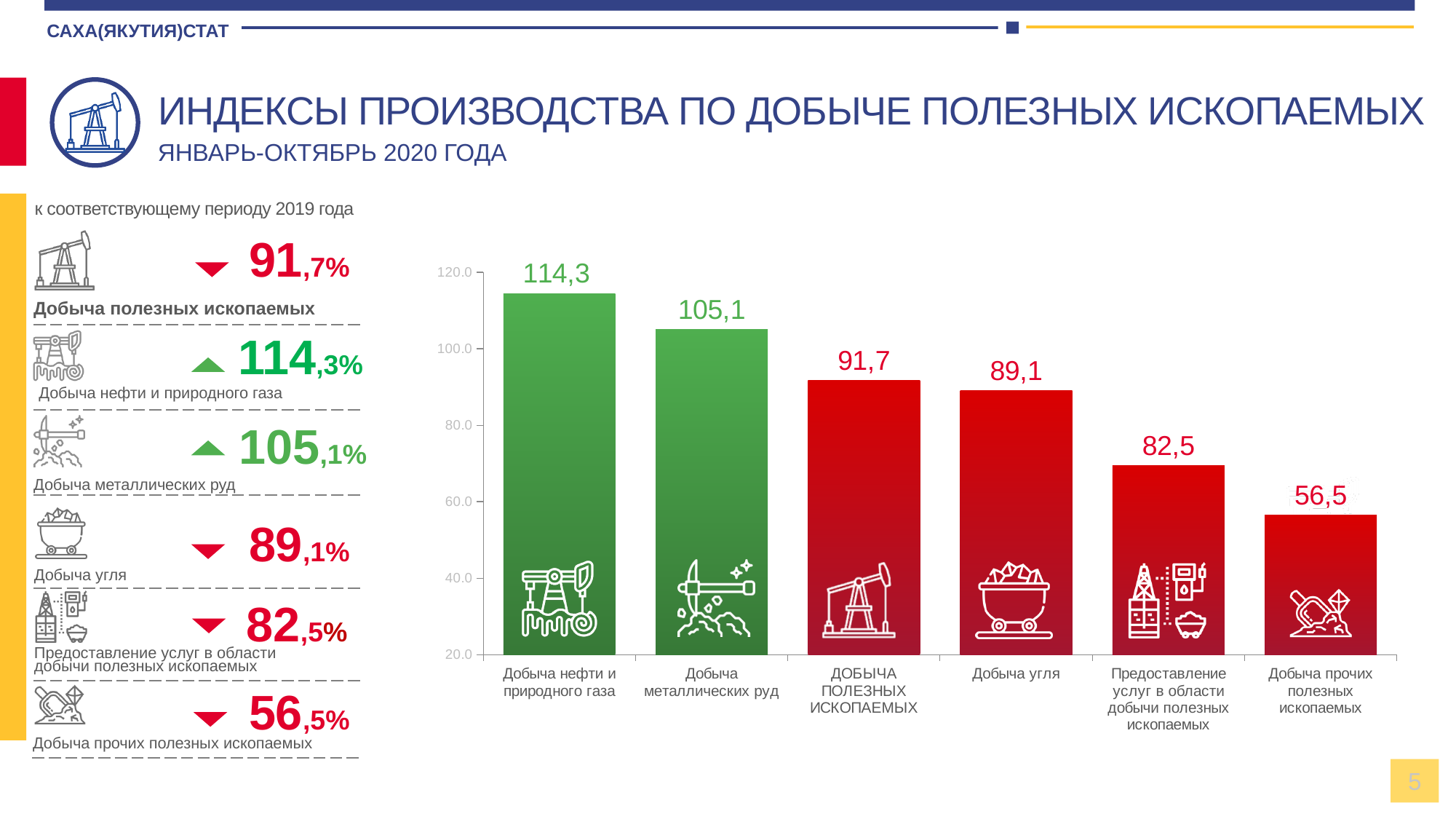
What is the value for Предоставление услуг в области добычи полезных ископаемых? 82,5 What is the difference between the values for Добыча нефти и природного газа and Добыча металлических руд? 9,2 Which category has the highest value? Добыча нефти и природного газа What kind of chart is shown on the slide? bar chart Is the value for Добыча прочих полезных ископаемых greater or less than 60.0? less Do the values rise or fall from left to right along the x axis? fall Which is larger, the value for Добыча металлических руд or the value for Добыча угля? Добыча металлических руд Which category has the lowest value? Добыча прочих полезных ископаемых How many categories are shown in the chart? 6 What is the value for Добыча нефти и природного газа? 114,3 What is the difference between the values for Предоставление услуг в области добычи полезных ископаемых and Добыча прочих полезных ископаемых? 26,0 What is the value for Добыча угля? 89,1